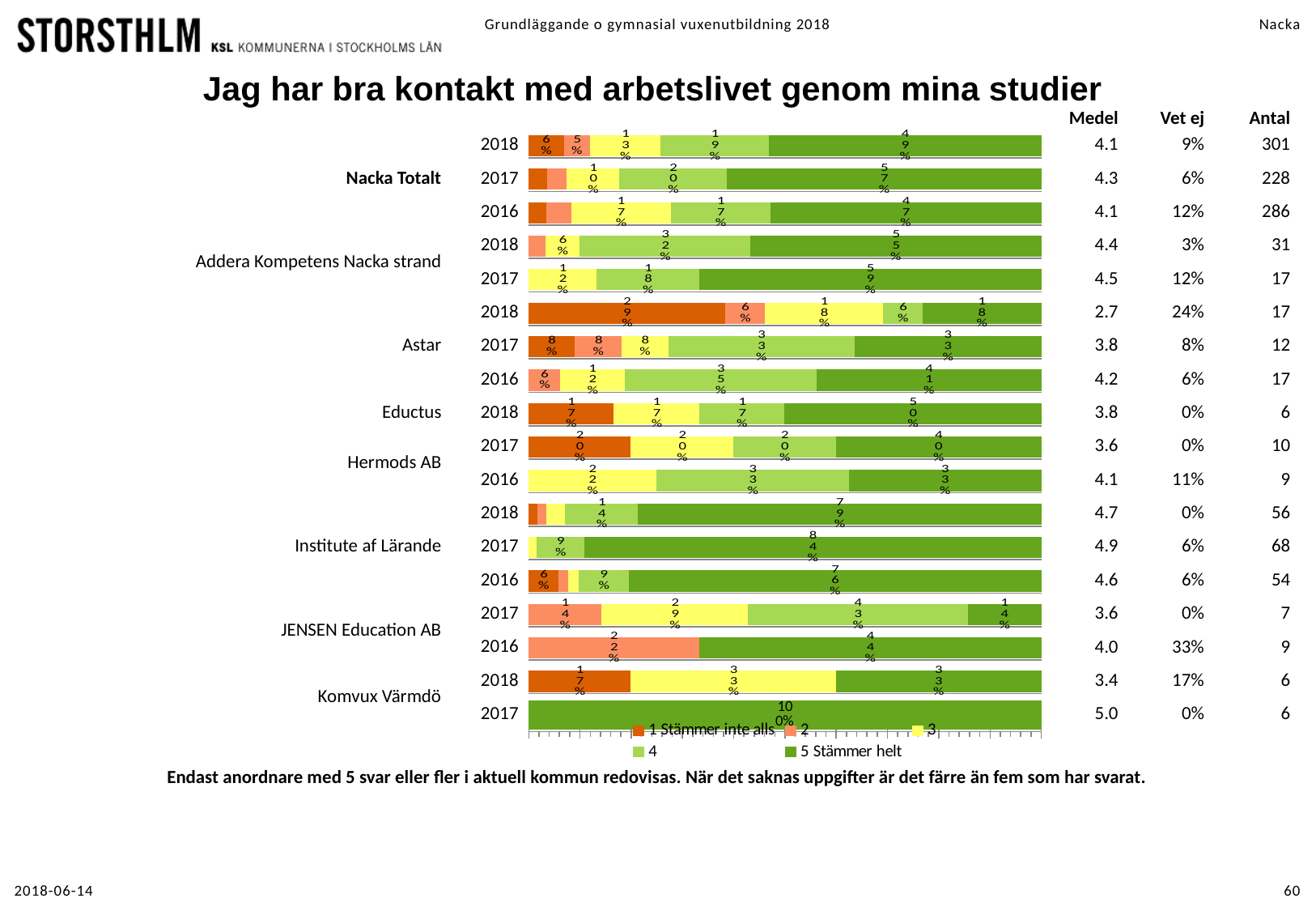
How many series does the chart legend list? 5 What is the value of the '5 Stämmer helt' segment for Institute af Lärande in 2017? 84% What is the value of the '3' segment for JENSEN Education AB in 2017? 29% What is the title of the chart? Jag har bra kontakt med arbetslivet genom mina studier What is the difference in percentage points between the '5 Stämmer helt' share for Nacka Totalt in 2017 and in 2016? 10 percentage points For Nacka Totalt, which year has the highest '5 Stämmer helt' share? 2017 What is the value of the '5 Stämmer helt' segment for Nacka Totalt in 2017? 57% What is the value of the '1 Stämmer inte alls' segment for Astar in 2018? 29% Which is larger, the '5 Stämmer helt' share for Institute af Lärande in 2018 or for Astar in 2018? Institute af Lärande 2018 What is the label of the first legend entry in the chart? 1 Stämmer inte alls What is the value of the '5 Stämmer helt' segment for Komvux Värmdö in 2017? 100% What kind of chart is shown on the slide? Stacked bar chart